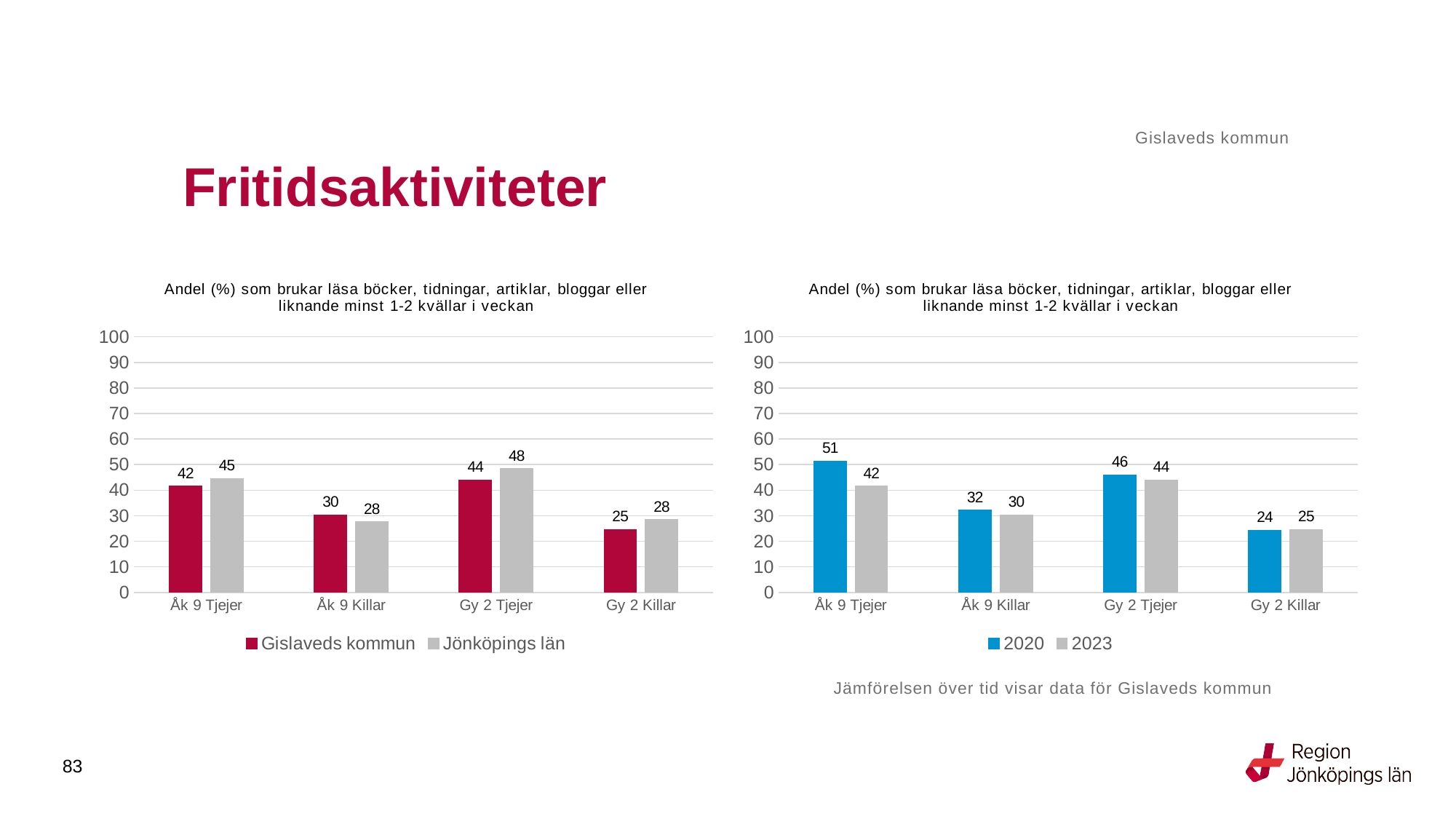
What kind of chart is the right chart? Bar chart In the right chart, what is the value for 2020 for Åk 9 Tjejer? 51 How many series does the legend of the left chart list? 2 In the left chart, what is the value for Jönköpings län for Gy 2 Tjejer? 48 In the left chart, which is larger for Åk 9 Killar: Gislaveds kommun or Jönköpings län? Gislaveds kommun How many categories are shown on the x axis of the right chart? 4 In the right chart, what is the value for 2023 for Gy 2 Killar? 25 In the right chart, what is the difference between the 2020 and 2023 values for Åk 9 Tjejer? 9 In the left chart, what is the difference between the Jönköpings län and Gislaveds kommun values for Gy 2 Tjejer? 4 In the right chart, which category has the highest value for 2020? Åk 9 Tjejer In the left chart, which category has the lowest value for Gislaveds kommun? Gy 2 Killar In the left chart, what is the value for Gislaveds kommun for Åk 9 Tjejer? 42